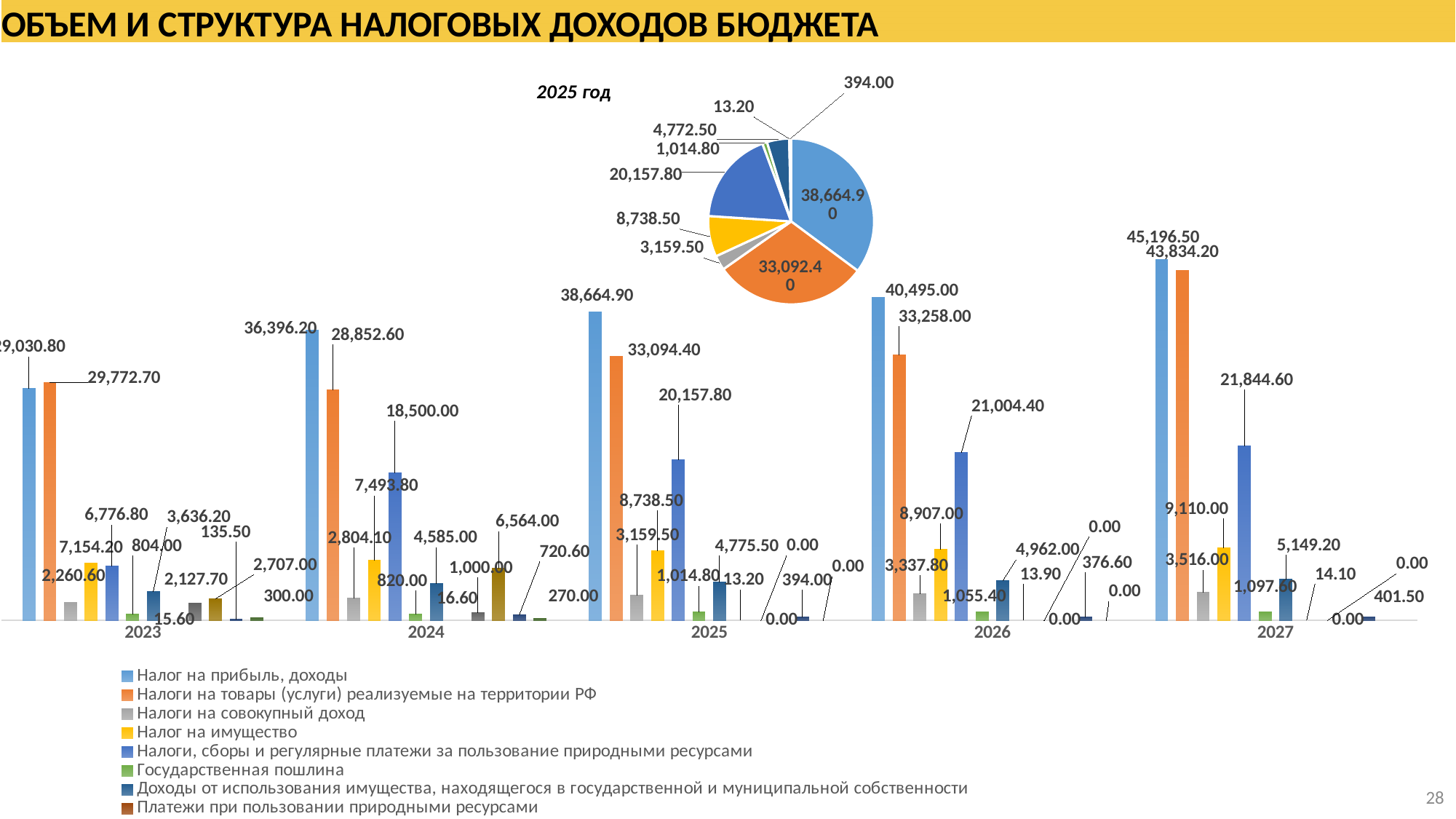
In the bar chart, what is the difference between Налог на прибыль, доходы and Налоги на товары (услуги) реализуемые на территории РФ in 2027? 1,362.30 In the bar chart for 2024, which is larger: Налог на прибыль, доходы or Налоги на товары (услуги) реализуемые на территории РФ? Налог на прибыль, доходы How many years are shown on the x axis of the bar chart? 5 In the bar chart, does Налог на прибыль, доходы rise or fall from 2023 to 2027? rises In the pie chart 2025 год, what is the value of the largest slice? 38,664.90 What kind of chart is the large chart showing values by year from 2023 to 2027? bar chart In the bar chart, what is the value of Налог на прибыль, доходы for 2027? 45,196.50 In the bar chart, what is the value of Налоги, сборы и регулярные платежи за пользование природными ресурсами for 2024? 18,500.00 What is the title of the pie chart at the top of the slide? 2025 год In the bar chart, in which year is Налог на прибыль, доходы the highest? 2027 In the bar chart, what is the value of Налоги на товары (услуги) реализуемые на территории РФ for 2025? 33,094.40 How many series does the legend of the bar chart list? 8